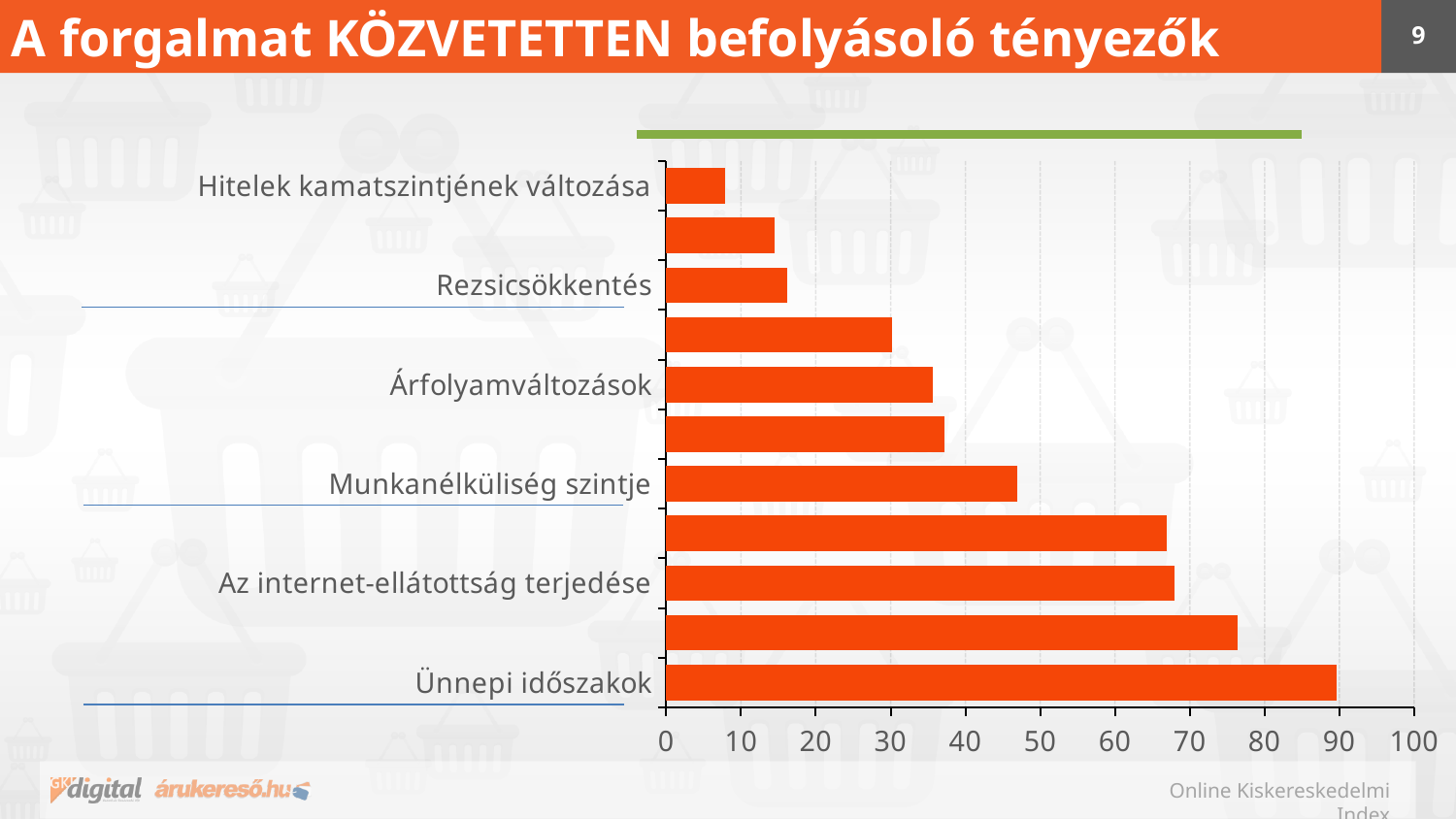
Is the value for Rezsicsökkentés greater or less than 20? less Which labelled category has the shortest bar? Hitelek kamatszintjének változása Which is larger, the value for Árfolyamváltozások or the value for Rezsicsökkentés? Árfolyamváltozások Is the value for Az internet-ellátottság terjedése greater or less than 60? greater Is the value for Ünnepi időszakok greater or less than 80? greater Which labelled category has the longest bar? Ünnepi időszakok How many bars are plotted in the chart? 11 What kind of chart is shown on the slide? bar chart Do the bars get longer or shorter going from the top of the chart to the bottom? longer What is the title of the slide containing the chart? A forgalmat KÖZVETETTEN befolyásoló tényezők